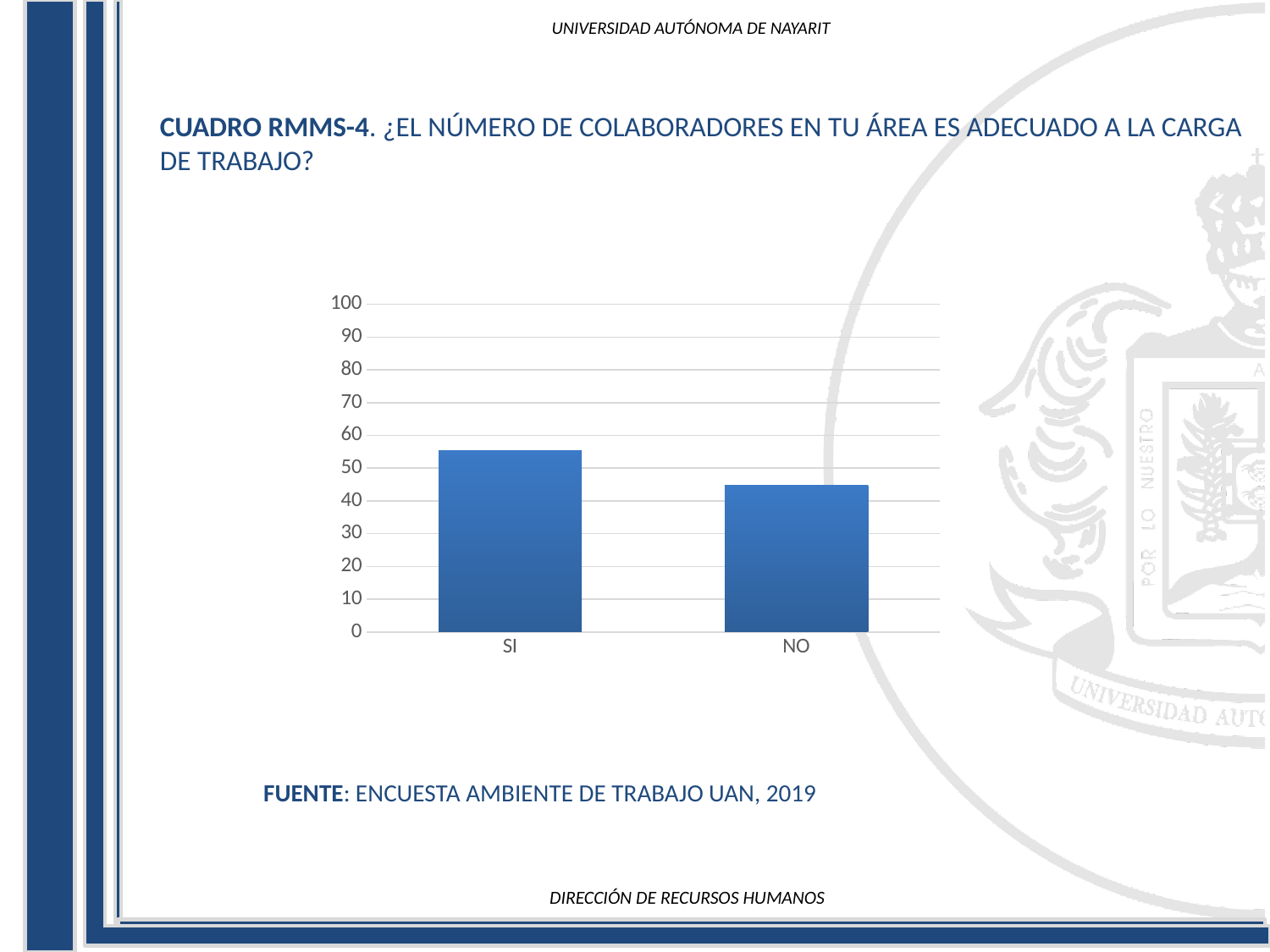
Is the value for NO greater or less than 50? less What kind of chart is shown on the slide? bar chart Is the value for SI greater or less than 60? less What is the source cited below the chart? ENCUESTA AMBIENTE DE TRABAJO UAN, 2019 Which category has the highest bar in the chart? SI What is the highest value shown on the vertical axis of the chart? 100 How many categories are shown on the x axis of the chart? 2 Which category has the lowest bar in the chart? NO Is the value for NO greater or less than 40? greater Which bar is taller, SI or NO? SI